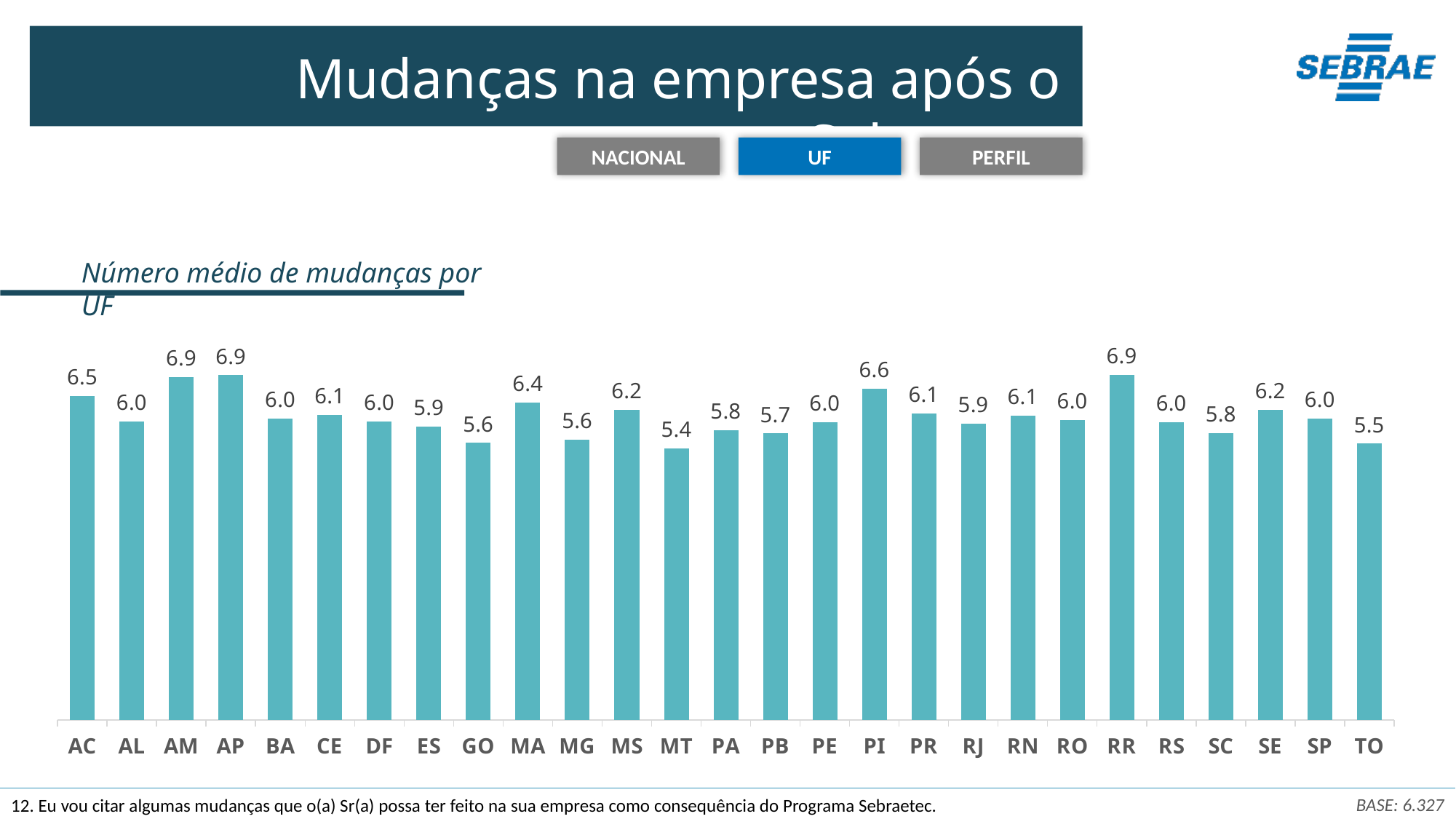
What is the title of the chart? Número médio de mudanças por UF What is the value shown for PI? 6.6 What is the difference between the values for RR and TO? 1.4 What is the value shown for MT? 5.4 Which has a higher value, PI or PB? PI How many UFs are shown in the chart? 27 What is the average number of changes for AC? 6.5 Which has a higher value, GO or MS? MS What is the value shown for SP? 6.0 Which UF has the lowest average number of changes? MT What is the difference between the values for MA and MG? 0.8 What kind of chart is shown on the slide? Bar chart